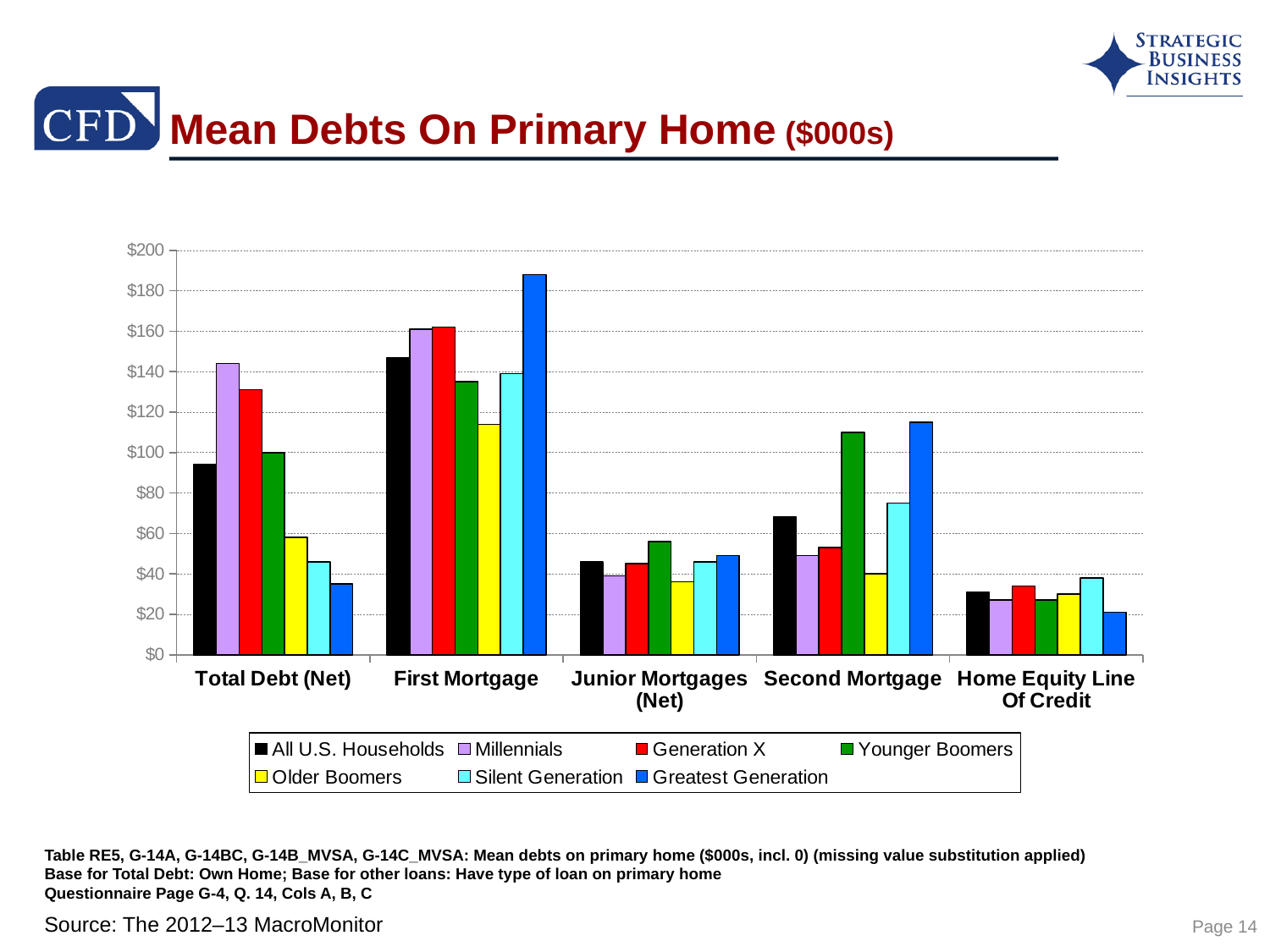
Is the First Mortgage value for the Greatest Generation greater or less than $180? greater What is the title of the chart? Mean Debts On Primary Home ($000s) Which generation has the highest mean First Mortgage debt? Greatest Generation Is the Total Debt (Net) value for Millennials greater or less than $120? greater How many debt categories are shown along the x axis? 5 Which generation has the lowest mean Total Debt (Net)? Greatest Generation For Second Mortgage, which is larger: Younger Boomers or Silent Generation? Younger Boomers How many series does the legend list? 7 Which generation has the lowest mean Home Equity Line Of Credit debt? Greatest Generation What kind of chart is shown on the slide? bar chart Is the Total Debt (Net) value for Older Boomers greater or less than $80? less Which generation has the highest mean Total Debt (Net)? Millennials